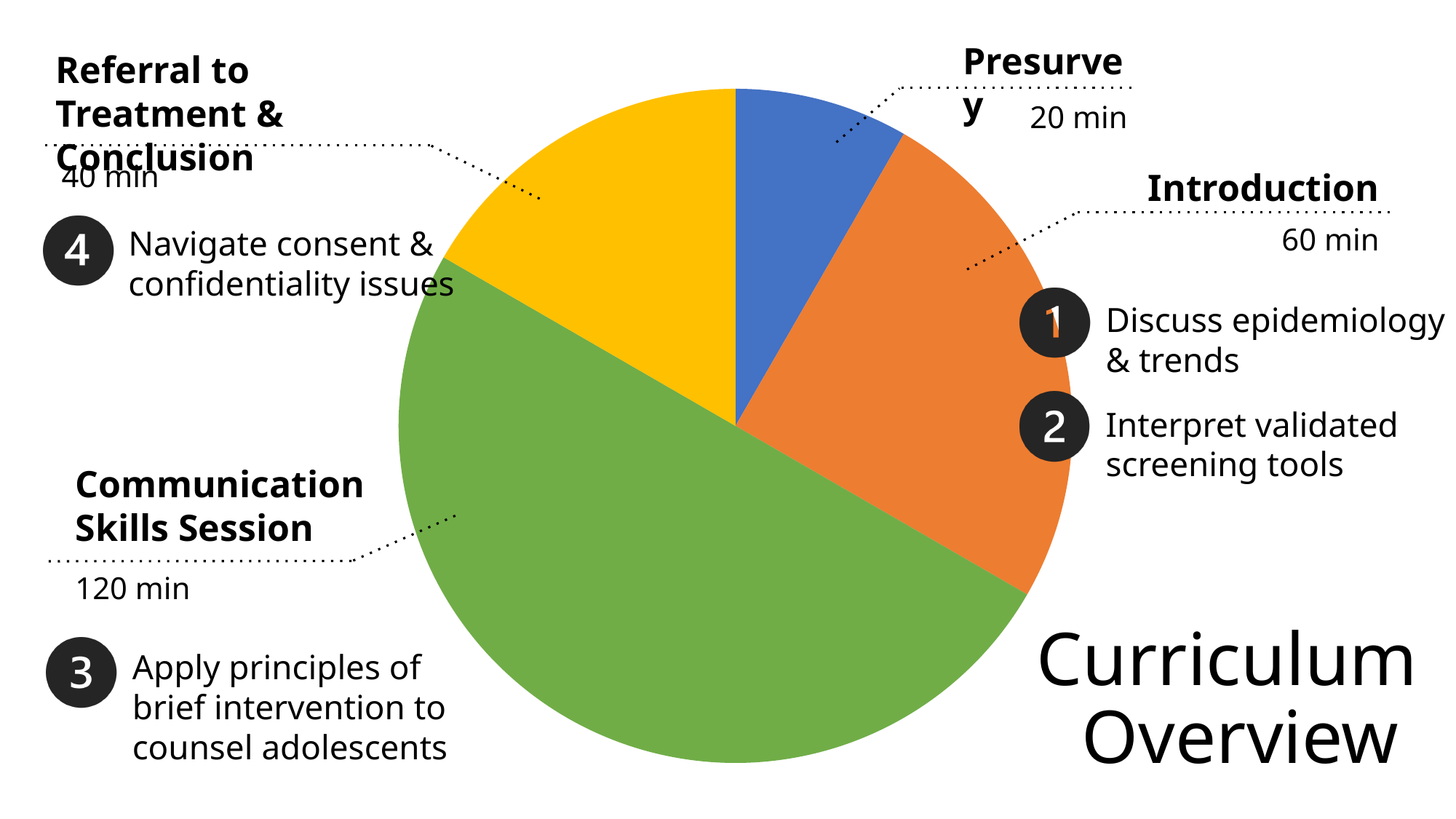
How many minutes are allotted to the Introduction? 60 min What share of the total curriculum time does the Communication Skills Session represent? 50% Which session takes the least time? Presurvey Which takes longer, the Introduction or Referral to Treatment & Conclusion? Introduction How many minutes are allotted to Referral to Treatment & Conclusion? 40 min What kind of chart is shown on the slide? Pie chart How many more minutes does the Communication Skills Session take than the Introduction? 60 min How many minutes are allotted to the Presurvey? 20 min Which session takes the most time? Communication Skills Session How many slices does the pie chart have? 4 What is the title shown on the slide? Curriculum Overview How many minutes are allotted to the Communication Skills Session? 120 min